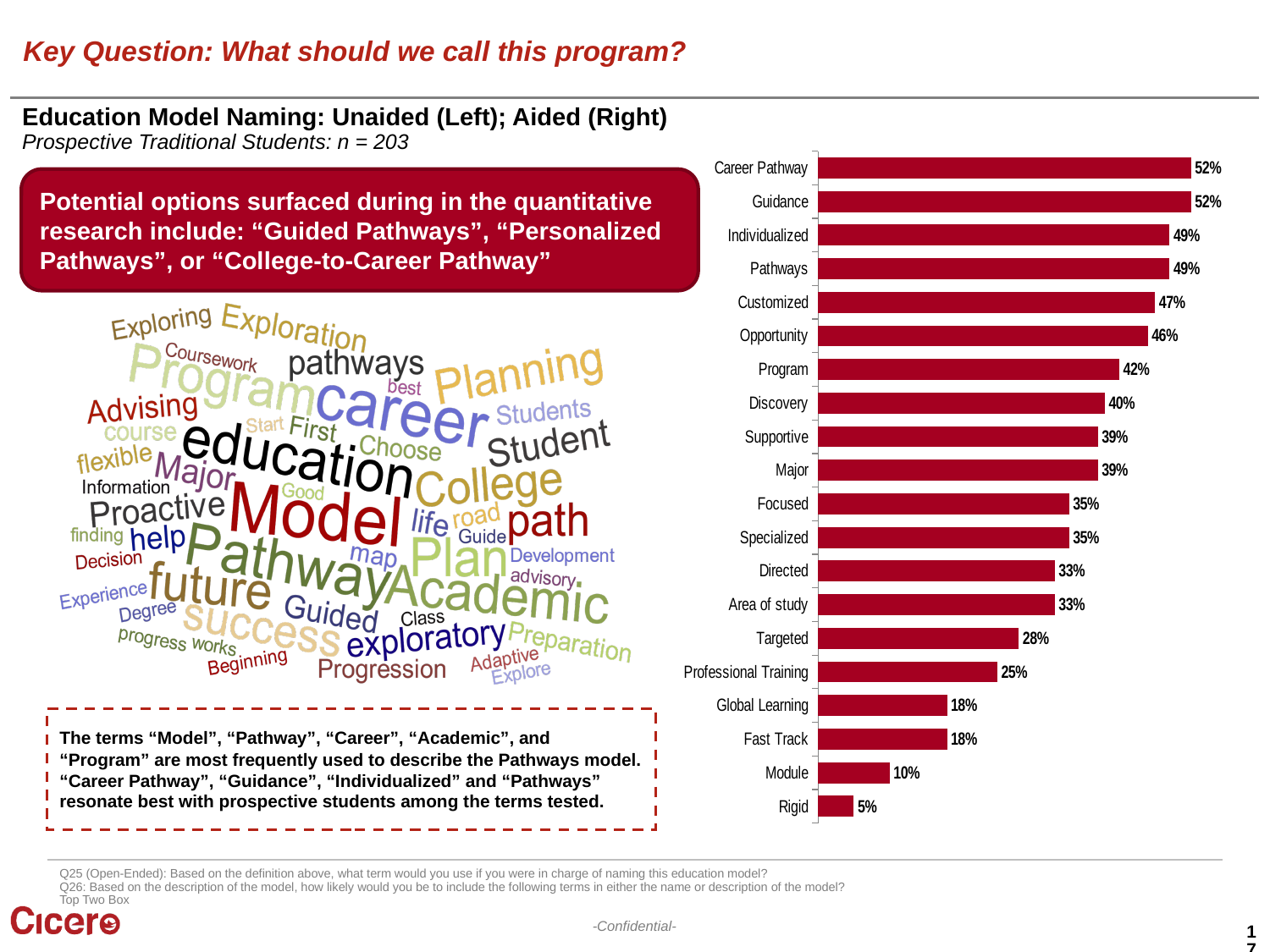
In the bar chart, which term has the lowest value? Rigid How many terms are plotted in the bar chart? 20 What is the sample size (n) stated in the chart subtitle? 203 In the bar chart, what is the difference between the values for Program and Targeted? 14% In the bar chart, what is the value for Customized? 47% In the bar chart, what is the difference between the values for Career Pathway and Rigid? 47% In the bar chart, which is larger, the value for Opportunity or the value for Discovery? Opportunity In the bar chart, which is larger, the value for Fast Track or the value for Directed? Directed In the bar chart, what is the value for Professional Training? 25% What kind of chart is shown on the right side of the slide? bar chart In the bar chart, what is the value for Module? 10% In the bar chart, what is the value for Individualized? 49%